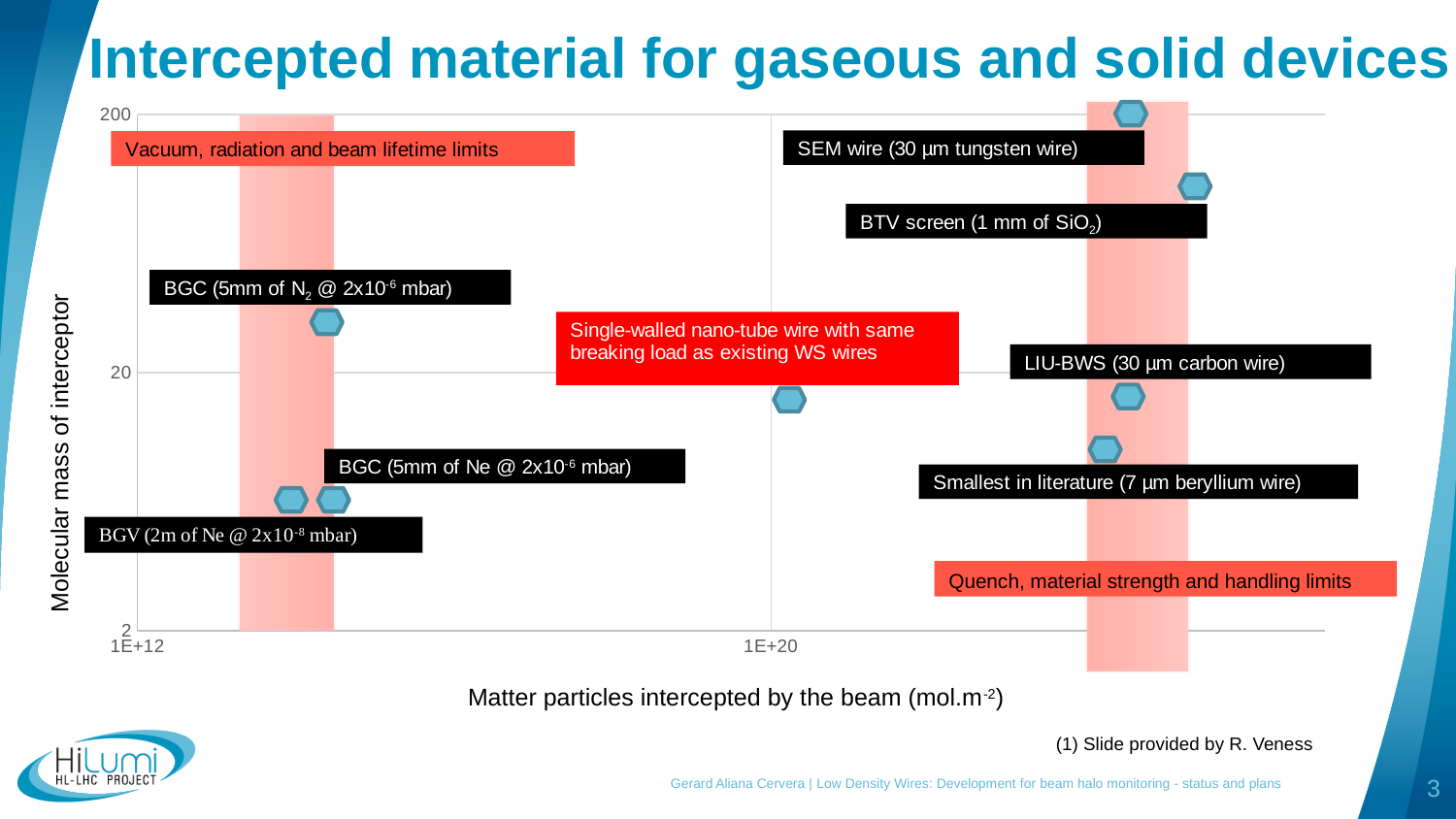
How many data points are plotted on the chart? 8 Which has a higher molecular mass of interceptor, the SEM wire (30 µm tungsten wire) or the BGC (5mm of Ne @ 2x10-6 mbar)? SEM wire (30 µm tungsten wire) Is the molecular mass of interceptor for the smallest in literature (7 µm beryllium wire) greater or less than 20? less Is the molecular mass of interceptor for the BGV (2m of Ne @ 2x10-8 mbar) greater or less than 20? less Is the matter intercepted by the beam for the BGC (5mm of N2 @ 2x10-6 mbar) greater or less than 1E+20? less Which labelled device has the highest molecular mass of interceptor? SEM wire (30 µm tungsten wire) What is the title of the chart's horizontal axis? Matter particles intercepted by the beam (mol.m-2) What is the title of the chart's vertical axis? Molecular mass of interceptor What kind of chart is shown on the slide? scatter chart